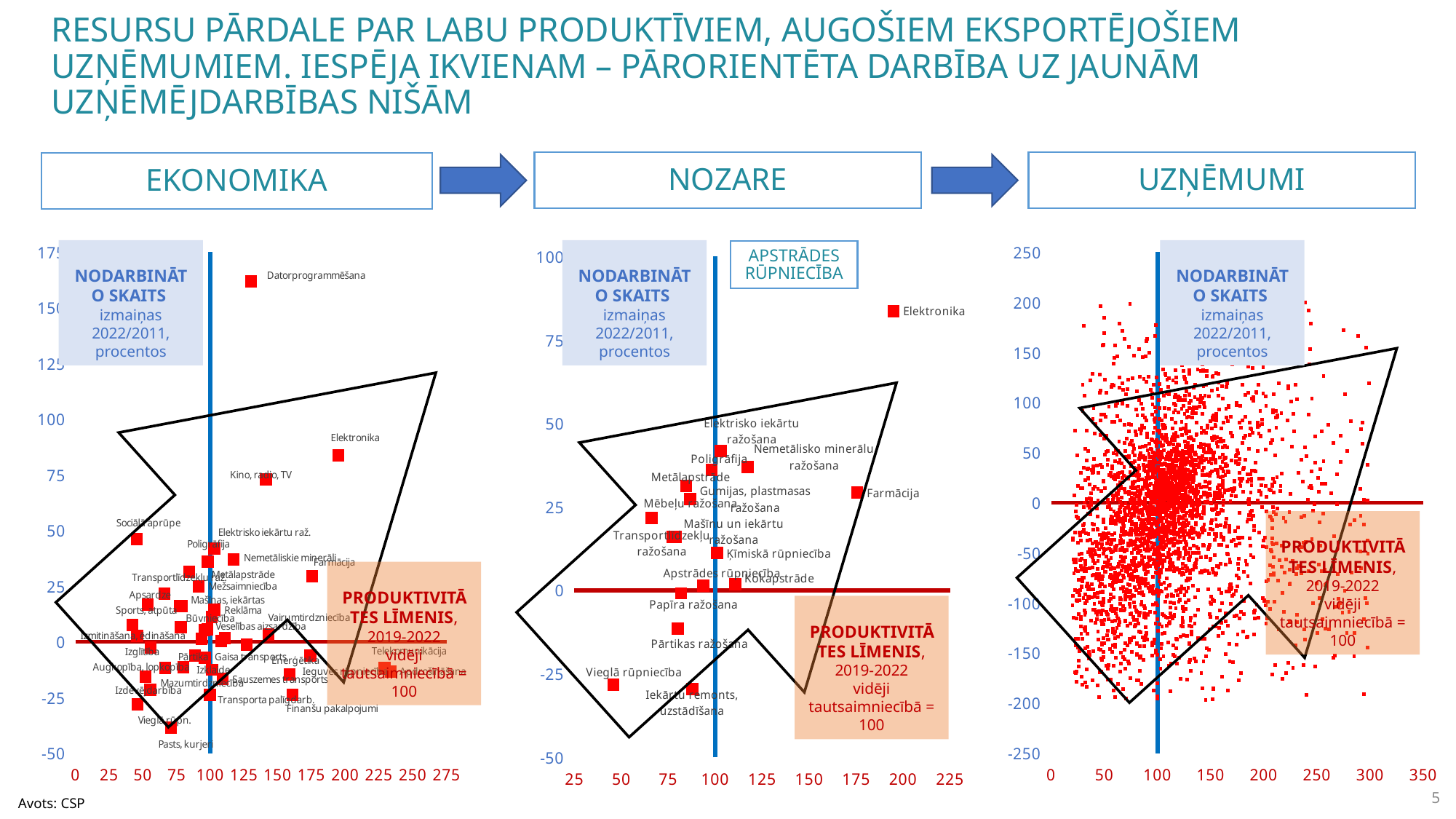
On the middle chart (NOZARE), is the productivity level (x value) for Farmācija greater or less than 150? greater On the middle chart (NOZARE), which labelled point has the highest employment change (y value)? Elektronika On the left chart (EKONOMIKA), is the productivity level (x value) for Elektronika greater or less than 175? greater What kind of chart is the left chart (EKONOMIKA)? scatter chart On the left chart (EKONOMIKA), which has the higher employment change: Elektronika or Kino, radio, TV? Elektronika How many charts are shown on the slide? 3 On the left chart (EKONOMIKA), which labelled point has the highest employment change (y value)? Datorprogrammēšana What is the highest value shown on the x axis of the right chart (UZŅĒMUMI)? 350 On the left chart (EKONOMIKA), is the employment change value for Datorprogrammēšana greater or less than 150? greater What kind of chart is the right chart (UZŅĒMUMI)? scatter chart